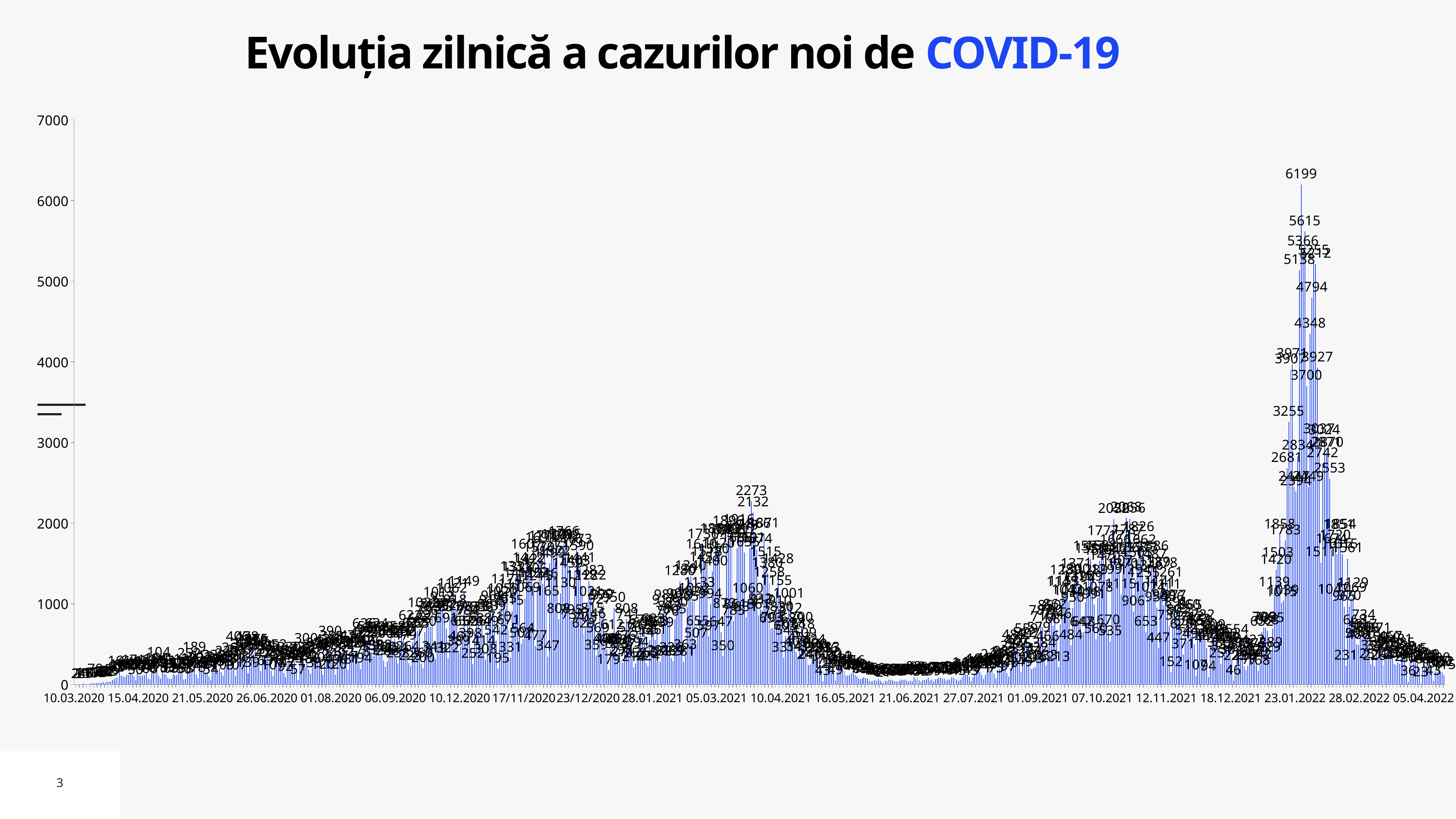
Is the highest bar on the chart greater or less than 6000? greater What is the highest tick value shown on the vertical axis? 7000 Are the daily values around 21.06.2021 greater or less than 1000? less Do the values rise or fall between 23.01.2022 and 05.04.2022? fall What is the difference between the overall peak of 6199 and the peak of 2273 around 05.03.2021? 3926 What is the second-highest value labelled on the chart, just below the 6199 peak? 5615 What kind of chart is shown on the slide? bar chart What is the first date shown on the horizontal axis? 10.03.2020 What is the peak value labelled around 05.03.2021? 2273 Which period has the higher peak: around 05.03.2021 or around 23.01.2022? around 23.01.2022 What is the highest daily value labelled on the chart? 6199 What is the title of the chart? Evoluția zilnică a cazurilor noi de COVID-19